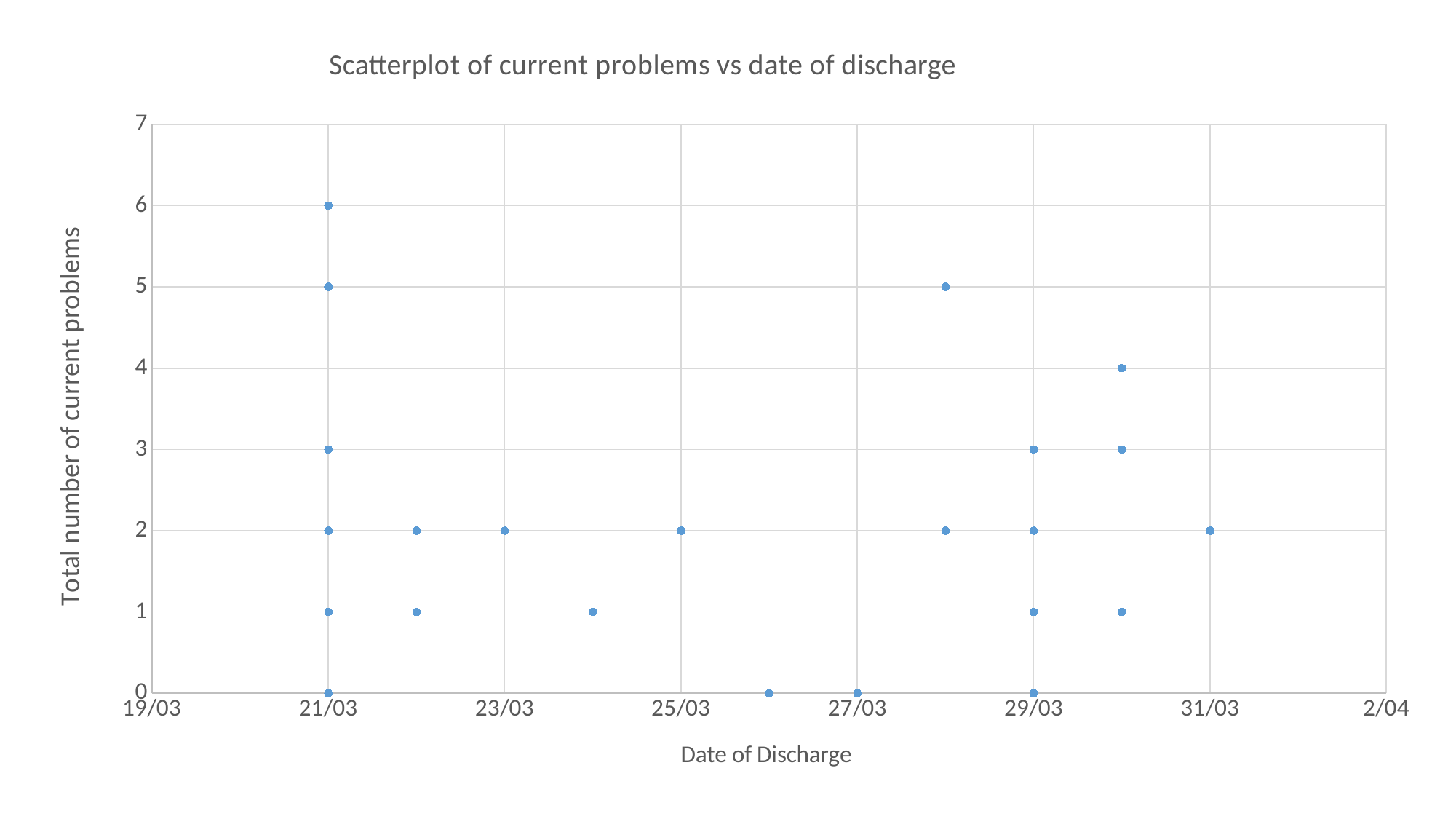
What is the label of the y axis? Total number of current problems What is the title of the chart? Scatterplot of current problems vs date of discharge On which date of discharge does the highest point (6 current problems) occur? 21/03 What is the highest total number of current problems plotted on the chart? 6 Which has the larger total number of current problems: the point at 25/03 or the point at 27/03? 25/03 What is the total number of current problems for the point at 23/03? 2 What kind of chart is shown on the slide? Scatter plot What is the difference between the highest point at 21/03 and the point at 23/03? 4 What is the total number of current problems for the point at 27/03? 0 What is the total number of current problems for the point at 31/03? 2